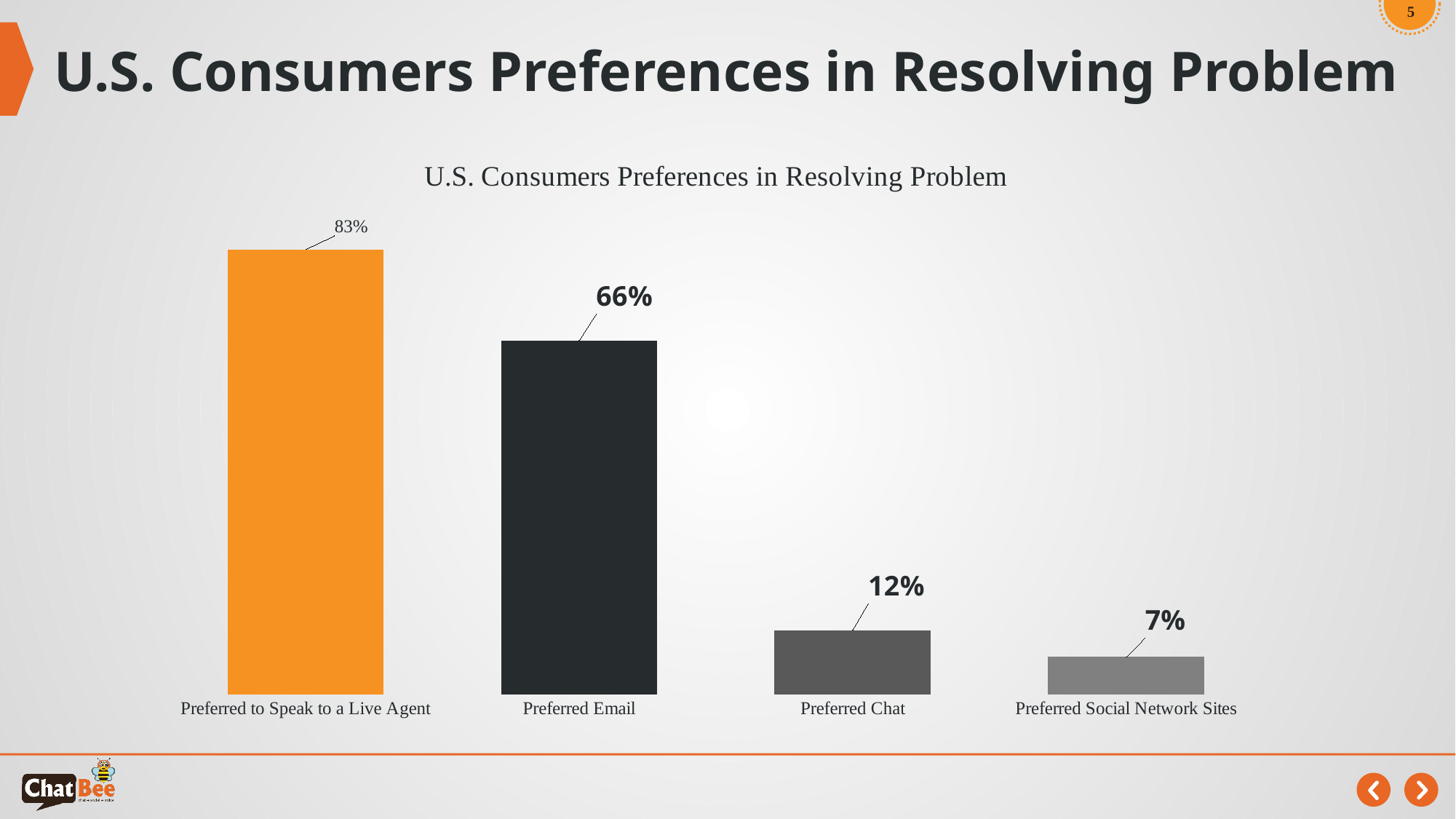
What is the difference between the values for Preferred Chat and Preferred Social Network Sites? 5% Which is larger, the value for Preferred Email or the value for Preferred Chat? Preferred Email What is the value for Preferred Chat? 12% How many categories are shown in the chart? 4 What is the value for Preferred to Speak to a Live Agent? 83% What is the difference between the values for Preferred to Speak to a Live Agent and Preferred Email? 17% What is the value for Preferred Email? 66% What is the value for Preferred Social Network Sites? 7% Which category has the highest value? Preferred to Speak to a Live Agent What is the title of the chart? U.S. Consumers Preferences in Resolving Problem What kind of chart is shown on the slide? Bar chart Which category has the lowest value? Preferred Social Network Sites